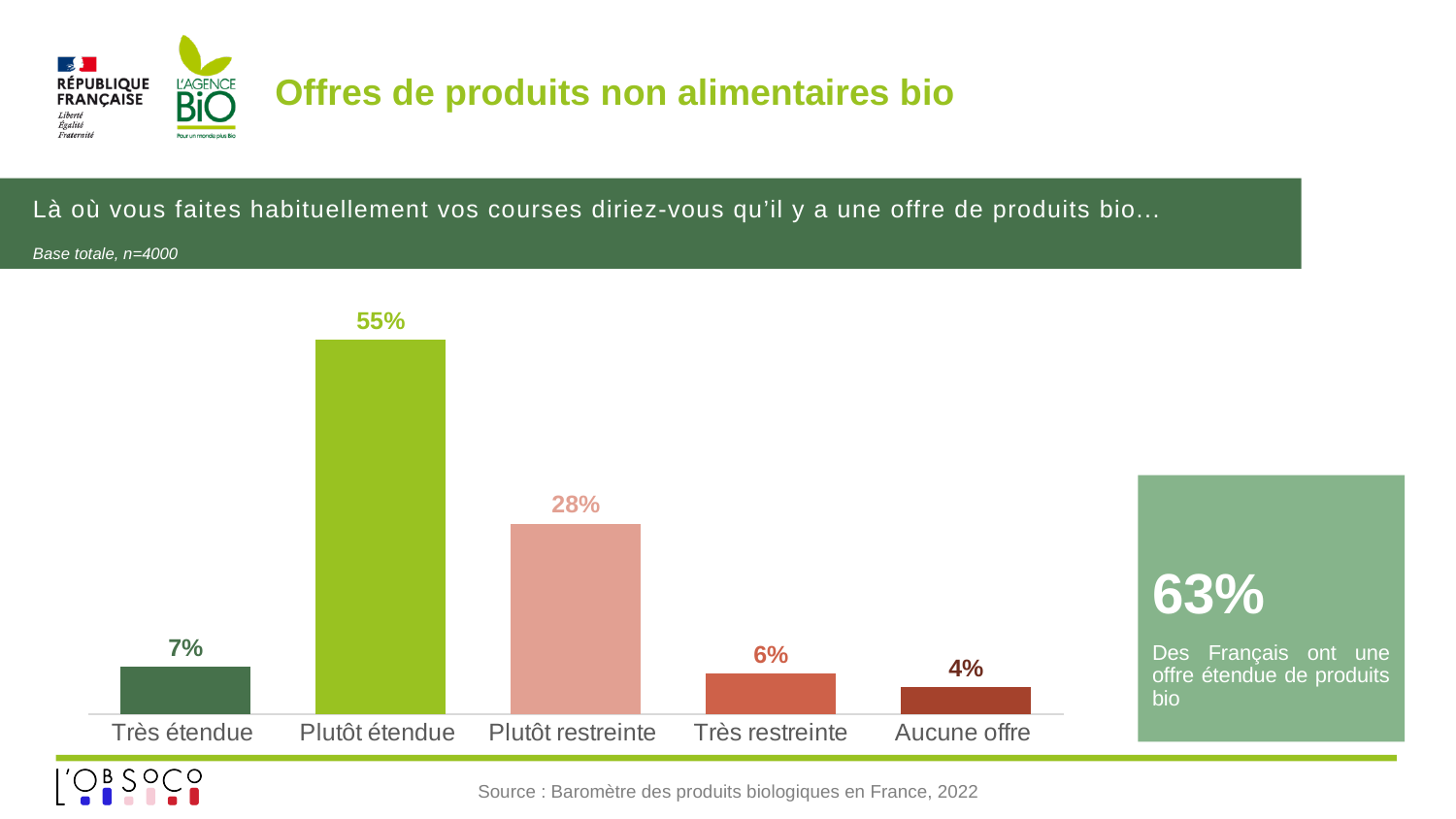
What is the combined value of "Très étendue" and "Plutôt étendue"? 62% What is the value for "Très étendue"? 7% Which is larger, the value for "Très étendue" or the value for "Très restreinte"? Très étendue What is the title of the slide containing the chart? Offres de produits non alimentaires bio What kind of chart is shown on the slide? Bar chart What is the value for "Plutôt restreinte"? 28% How many categories are shown on the chart? 5 What is the value for "Aucune offre"? 4% What is the difference between the values for "Plutôt étendue" and "Plutôt restreinte"? 27% Which category has the highest value? Plutôt étendue Which category has the lowest value? Aucune offre What is the value for "Plutôt étendue"? 55%